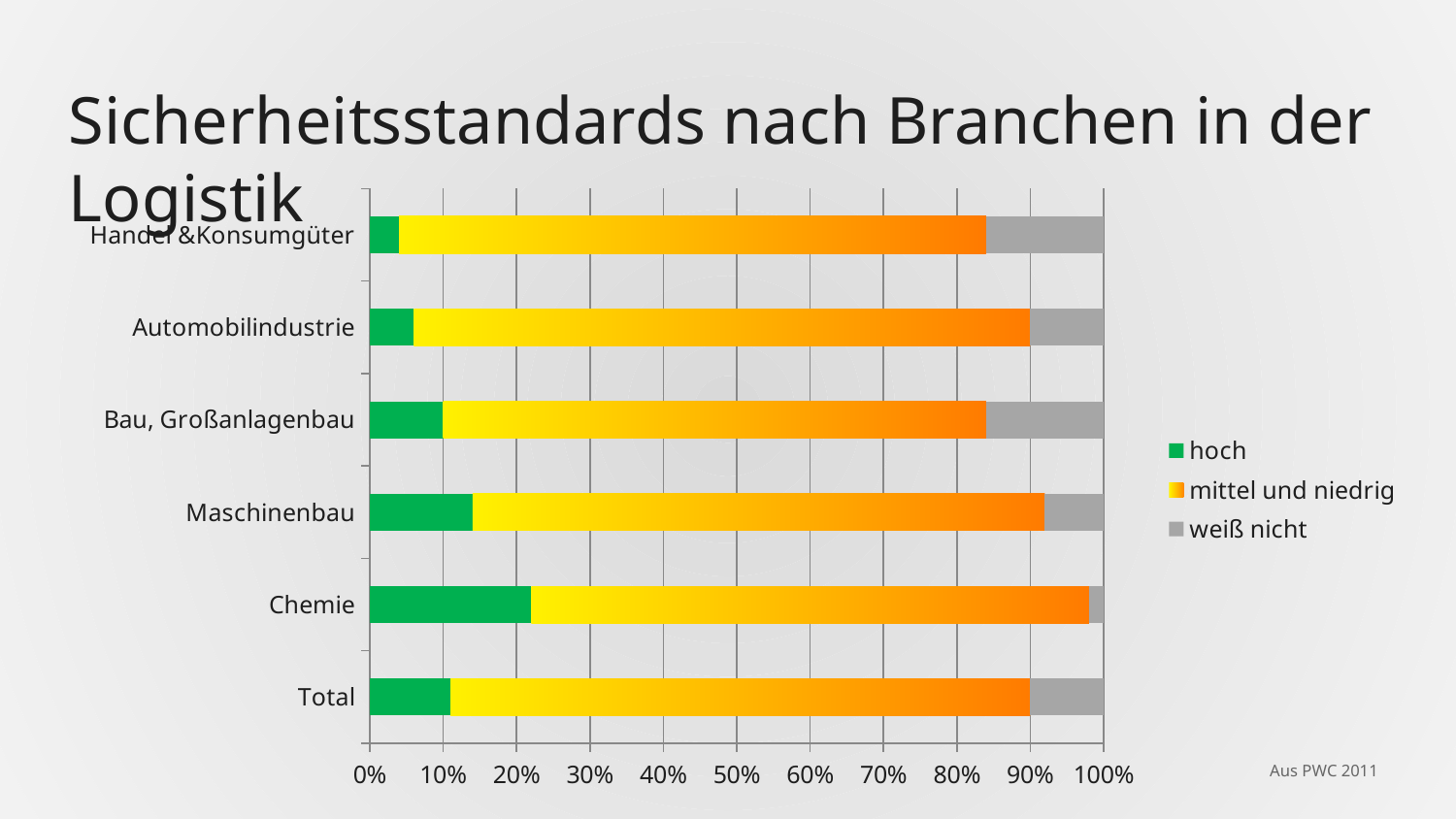
Which has the larger 'hoch' share, Bau, Großanlagenbau or Handel & Konsumgüter? Bau, Großanlagenbau Is the 'hoch' share for Chemie greater or less than 10%? greater What kind of chart is shown on the slide? Stacked bar chart Which category has the smallest 'weiß nicht' share? Chemie Which category has the largest 'hoch' share? Chemie Which has the larger 'hoch' share, Chemie or Maschinenbau? Chemie Is the 'hoch' share for Maschinenbau greater or less than 10%? greater How many series does the legend list? 3 Is the 'hoch' share for Handel & Konsumgüter greater or less than 10%? less Which legend entry is shown in green? hoch What is the title of the slide? Sicherheitsstandards nach Branchen in der Logistik How many industry categories are plotted on the chart? 6